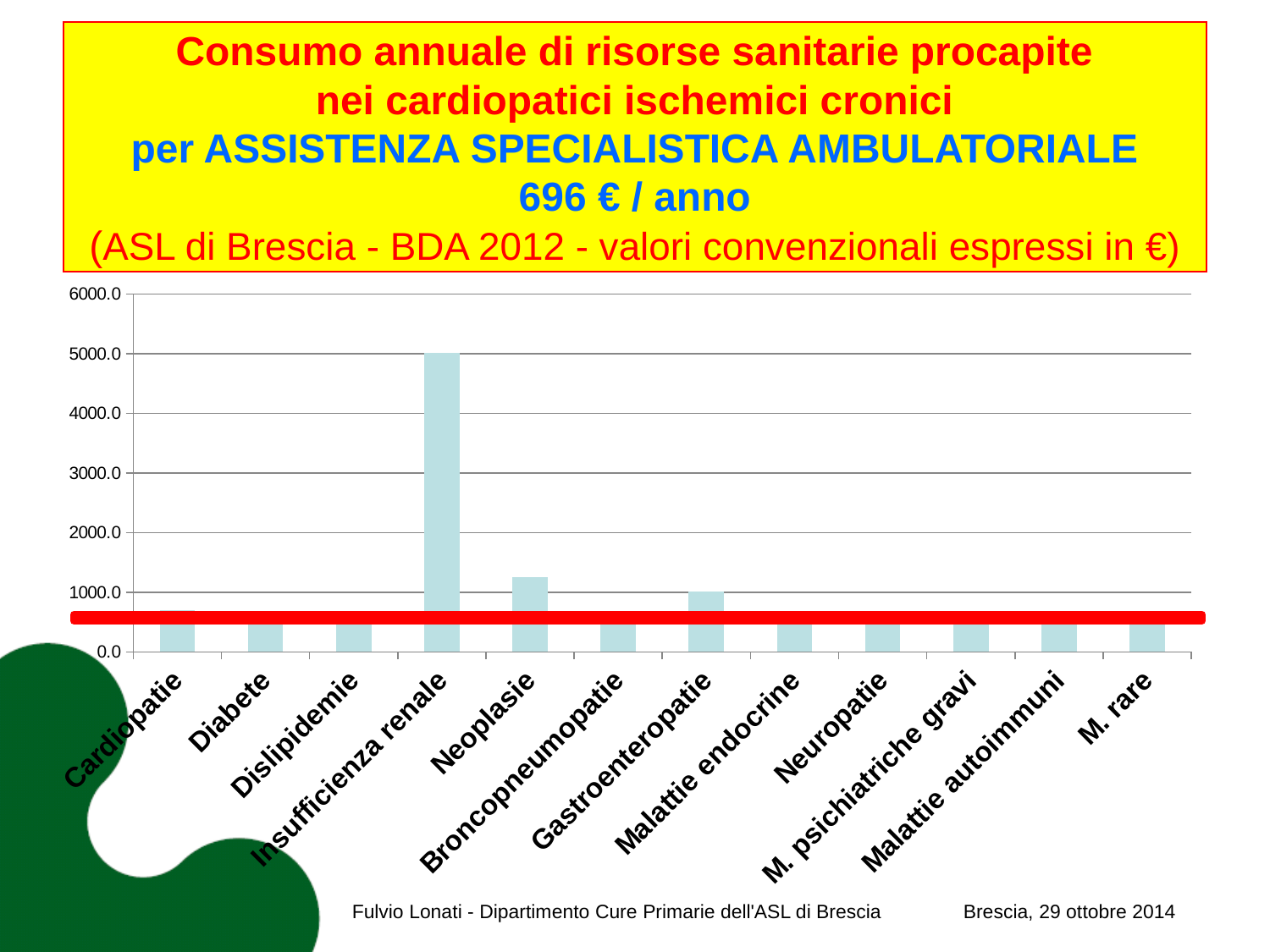
Is the value for Insufficienza renale greater or less than 4000? greater What kind of chart is shown on the slide? bar chart Is the value for Diabete greater or less than 1000? less Which is larger, the value for Neoplasie or the value for Gastroenteropatie? Neoplasie According to the slide title, what is the annual per-capita consumption for ASSISTENZA SPECIALISTICA AMBULATORIALE? 696 € / anno Which is larger, the value for Insufficienza renale or the value for Neoplasie? Insufficienza renale Is the value for Neoplasie greater or less than 1000? greater Which category has the highest bar in the chart? Insufficienza renale How many categories are shown on the x axis of the chart? 12 What is the highest value labelled on the y axis of the chart? 6000.0